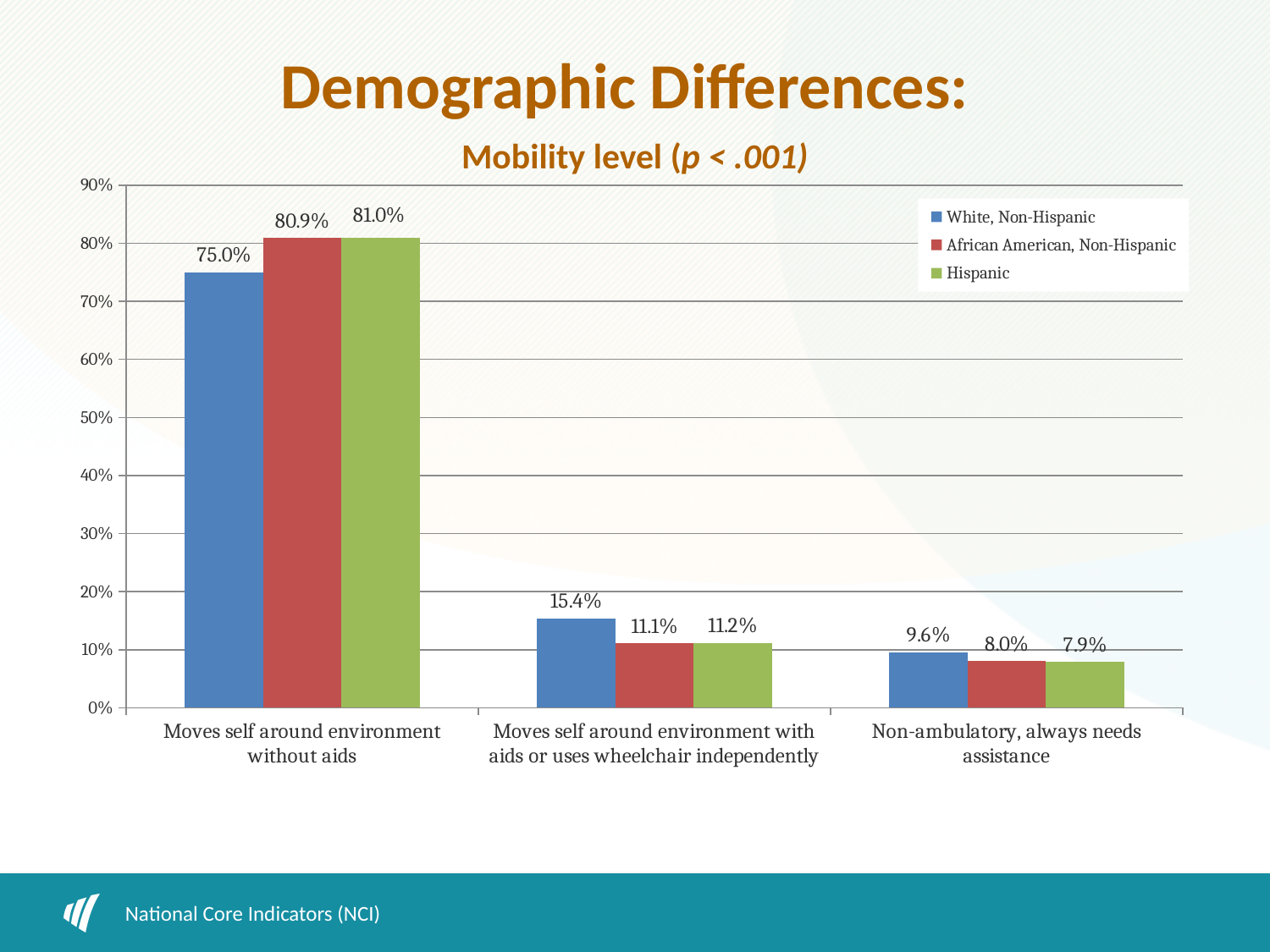
How many series does the legend list? 3 What is the value for White, Non-Hispanic in the 'Moves self around environment without aids' category? 75.0% What is the difference between the White, Non-Hispanic and African American, Non-Hispanic values in the 'Moves self around environment with aids or uses wheelchair independently' category? 4.3% What kind of chart is shown on the slide? Bar chart What is the value for African American, Non-Hispanic in the 'Non-ambulatory, always needs assistance' category? 8.0% How many categories are shown on the x axis? 3 What is the value for Hispanic in the 'Moves self around environment with aids or uses wheelchair independently' category? 11.2% Which is larger: the White, Non-Hispanic value or the Hispanic value in the 'Non-ambulatory, always needs assistance' category? White, Non-Hispanic Is the value for African American, Non-Hispanic in the 'Moves self around environment without aids' category greater or less than 80%? greater Which series has the highest value in the 'Moves self around environment without aids' category? Hispanic What colour represents the Hispanic series in the chart? Green Which series has the lowest value in the 'Non-ambulatory, always needs assistance' category? Hispanic